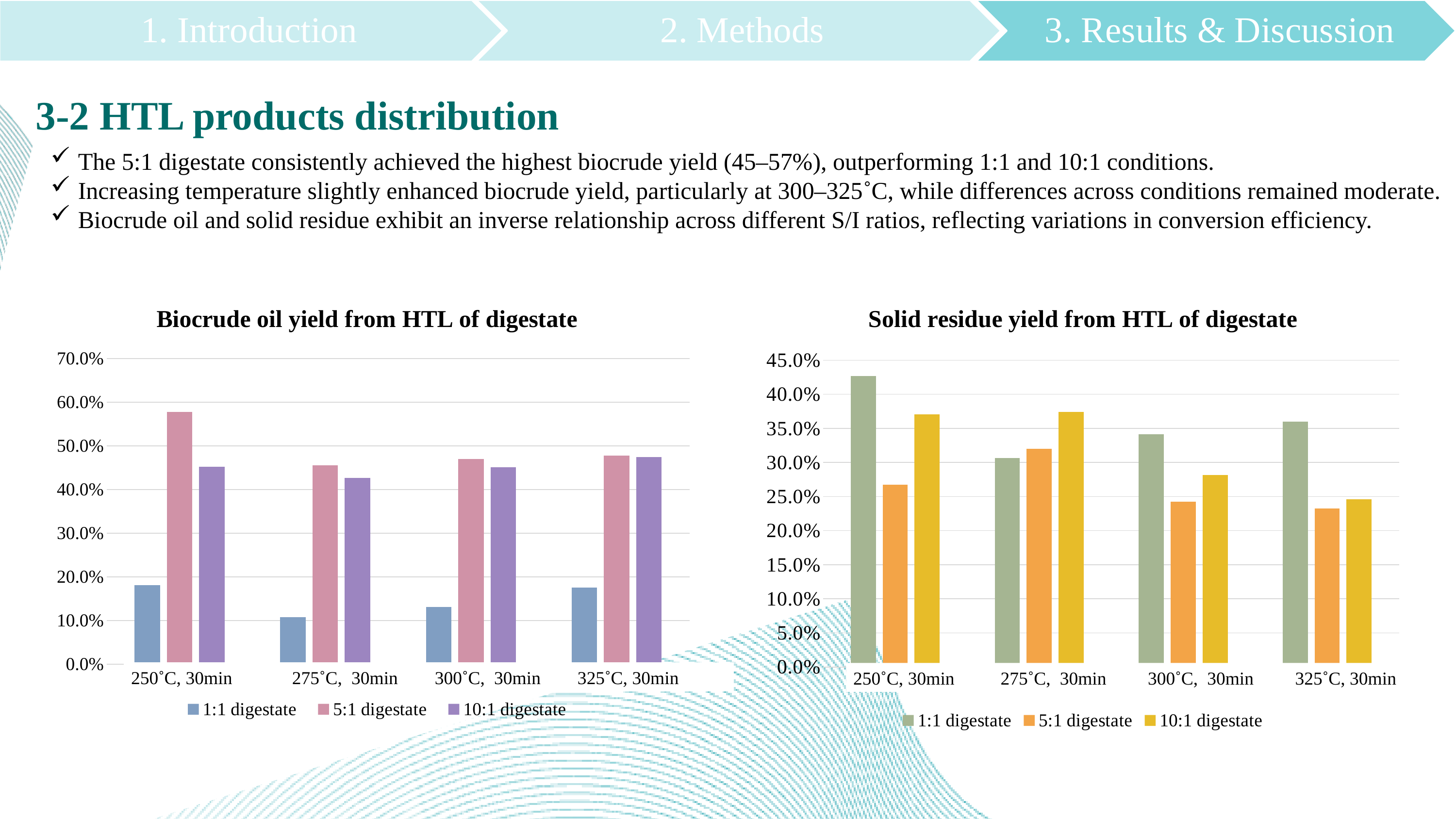
How many temperature conditions are shown on the x axis of the 'Biocrude oil yield from HTL of digestate' chart? 4 In the 'Biocrude oil yield from HTL of digestate' chart, is the 5:1 digestate value at 250˚C, 30min greater or less than 50.0%? greater What kind of chart is the 'Biocrude oil yield from HTL of digestate' chart? bar chart In the 'Solid residue yield from HTL of digestate' chart, at which condition is the 1:1 digestate yield highest? 250˚C, 30min What are the three legend entries of the 'Biocrude oil yield from HTL of digestate' chart? 1:1 digestate, 5:1 digestate, 10:1 digestate In the 'Biocrude oil yield from HTL of digestate' chart, at which condition is the 1:1 digestate yield lowest? 275˚C, 30min In the 'Solid residue yield from HTL of digestate' chart, is the 1:1 digestate value at 250˚C, 30min greater or less than 40.0%? greater How many series does the legend of the 'Solid residue yield from HTL of digestate' chart list? 3 In the 'Solid residue yield from HTL of digestate' chart, at 300˚C, 30min, which is larger: the 1:1 digestate or the 5:1 digestate? 1:1 digestate In the 'Biocrude oil yield from HTL of digestate' chart, at 250˚C, 30min, which is larger: the 5:1 digestate or the 10:1 digestate? 5:1 digestate In the 'Biocrude oil yield from HTL of digestate' chart, at which condition is the 5:1 digestate yield highest? 250˚C, 30min In the 'Biocrude oil yield from HTL of digestate' chart, is the 1:1 digestate value at 275˚C, 30min greater or less than 20.0%? less